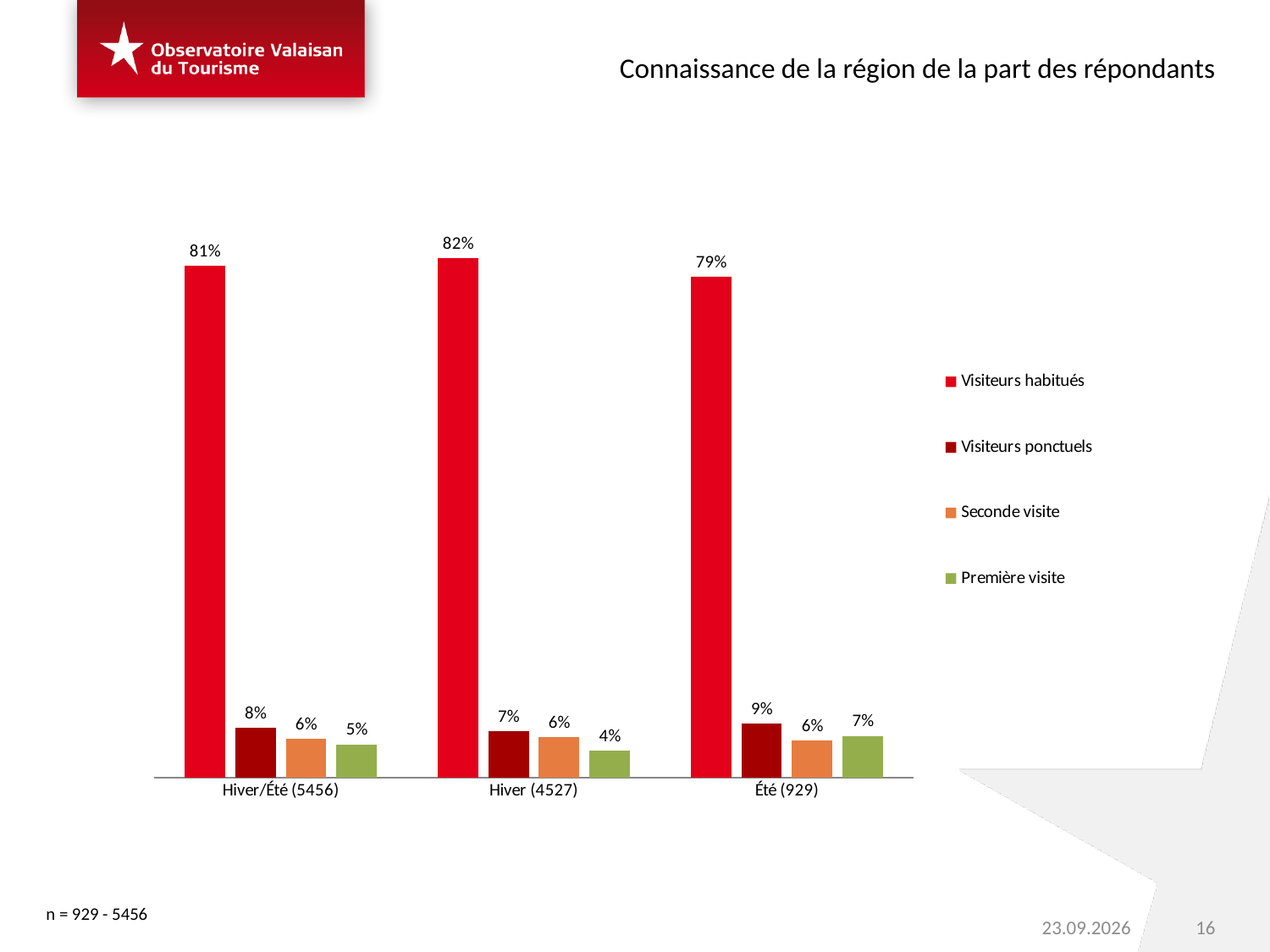
What is the value for Première visite in the Été (929) category? 7% Which category has the highest value for Visiteurs habitués? Hiver (4527) What kind of chart is shown on the slide? Bar chart What is the difference between the Visiteurs habitués values for Hiver (4527) and Été (929)? 3% What is the title of the chart? Connaissance de la région de la part des répondants What is the value for Visiteurs ponctuels in the Hiver/Été (5456) category? 8% How many categories are shown on the x axis? 3 Which is larger: Visiteurs ponctuels for Été (929) or Visiteurs ponctuels for Hiver (4527)? Été (929) What is the value for Visiteurs habitués in the Hiver (4527) category? 82% What is the value for Seconde visite in the Hiver (4527) category? 6% Which category has the lowest value for Première visite? Hiver (4527) How many series does the legend list? 4